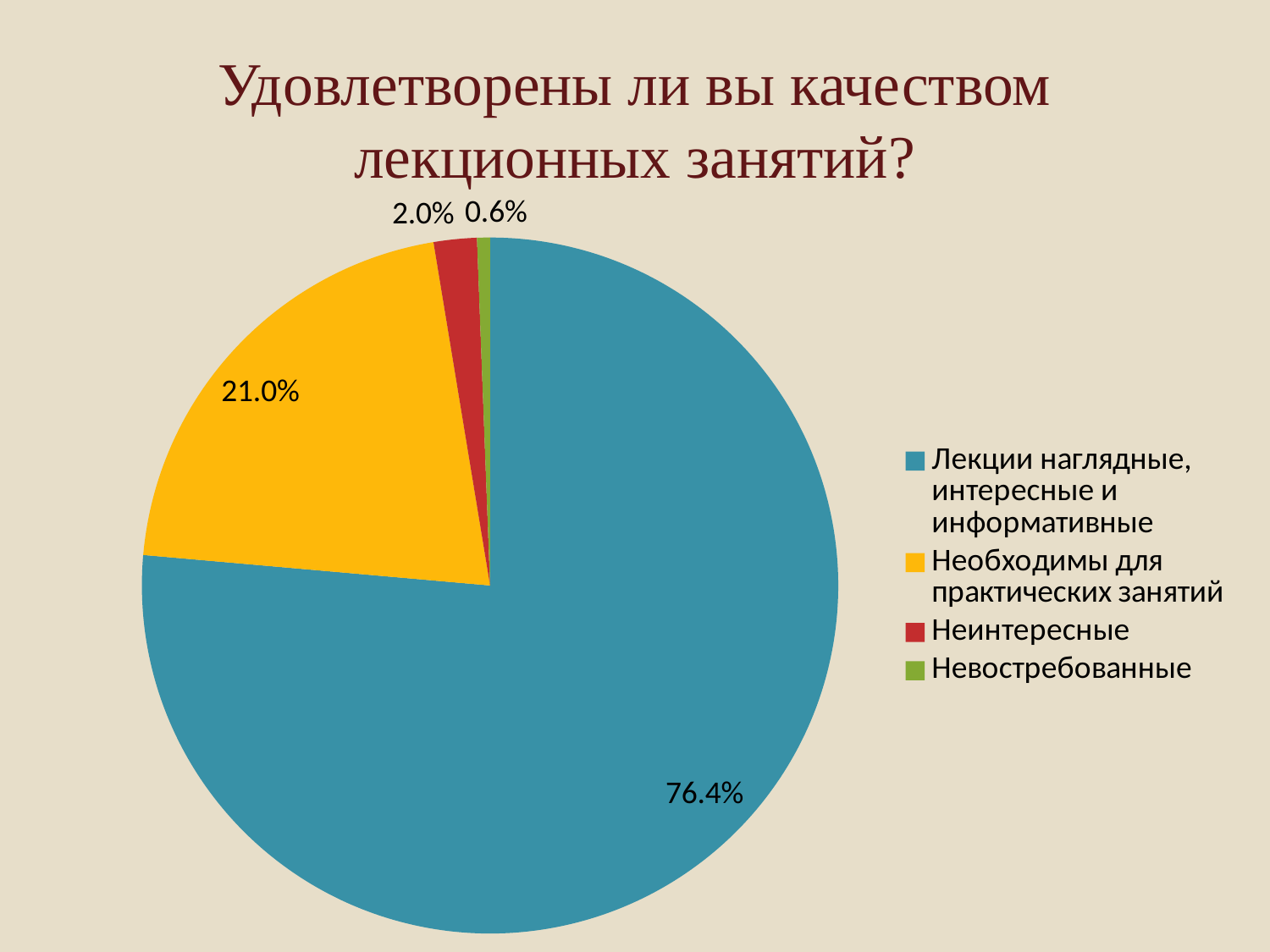
What colour is the slice for "Необходимы для практических занятий"? yellow What share of the pie is labelled for "Лекции наглядные, интересные и информативные"? 76.4% What kind of chart is shown on the slide? pie chart What share of the pie is labelled for "Необходимы для практических занятий"? 21.0% What is the difference between the shares for "Лекции наглядные, интересные и информативные" and "Необходимы для практических занятий"? 55.4% What share of the pie is labelled for "Невостребованные"? 0.6% What is the title of the slide above the chart? Удовлетворены ли вы качеством лекционных занятий? Which is larger: the share for "Неинтересные" or the share for "Невостребованные"? Неинтересные What share of the pie is labelled for "Неинтересные"? 2.0% Which category has the largest slice of the pie? Лекции наглядные, интересные и информативные Which category has the smallest slice of the pie? Невостребованные How many categories does the legend list? 4